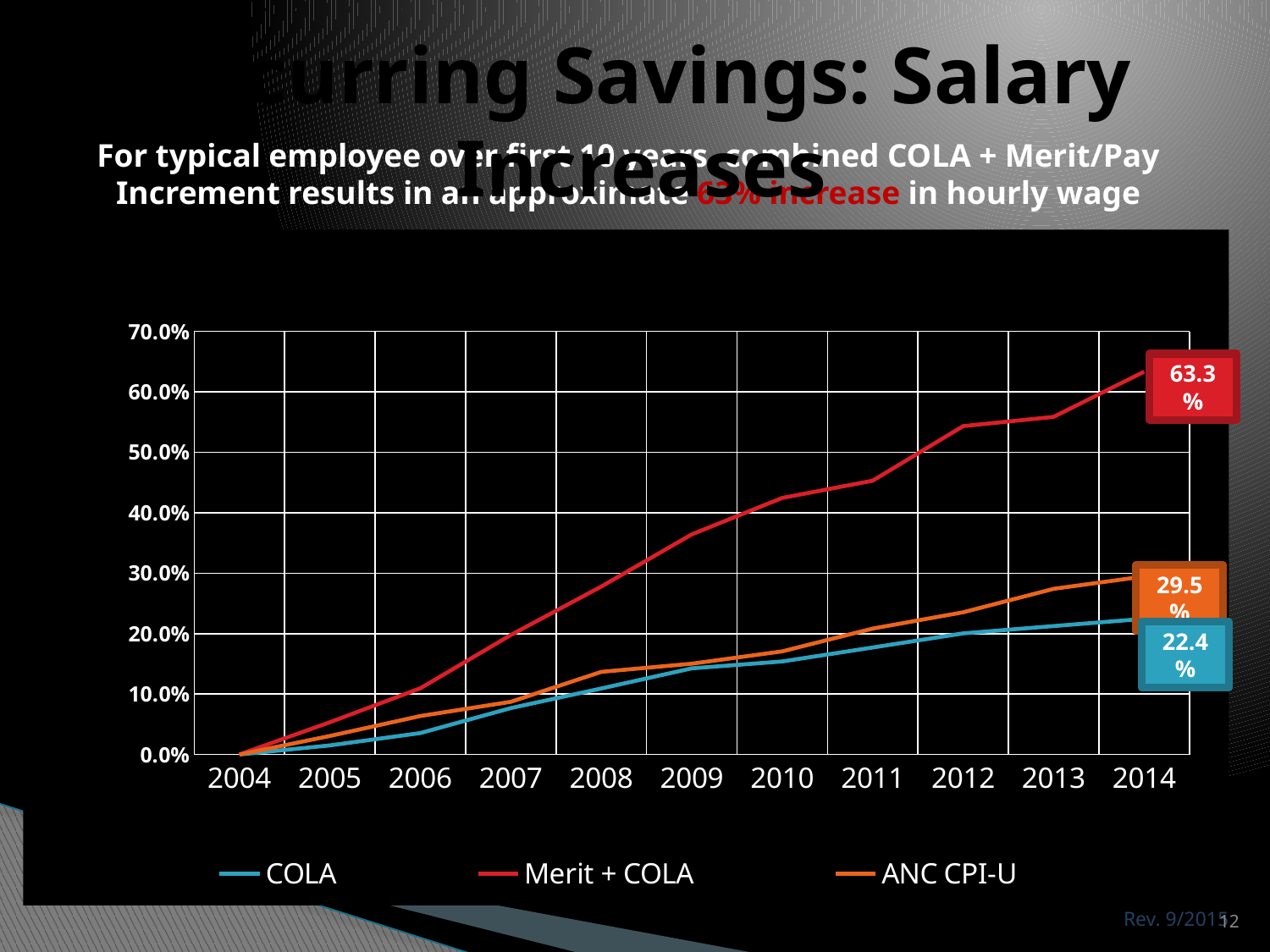
How many years are shown on the x axis? 11 What is the difference between the Merit + COLA and COLA values in 2014? 40.9 percentage points What is the value for ANC CPI-U in 2014? 29.5% Is the value for Merit + COLA in 2012 greater or less than 50.0%? greater Which series has the lowest value in 2014? COLA How many series does the legend list? 3 Which series has the highest value in 2014? Merit + COLA What is the value for COLA in 2014? 22.4% What is the difference between the ANC CPI-U and COLA values in 2014? 7.1 percentage points What kind of chart is shown on the slide? Line chart What is the value for Merit + COLA in 2014? 63.3% In 2014, which is larger: Merit + COLA or ANC CPI-U? Merit + COLA